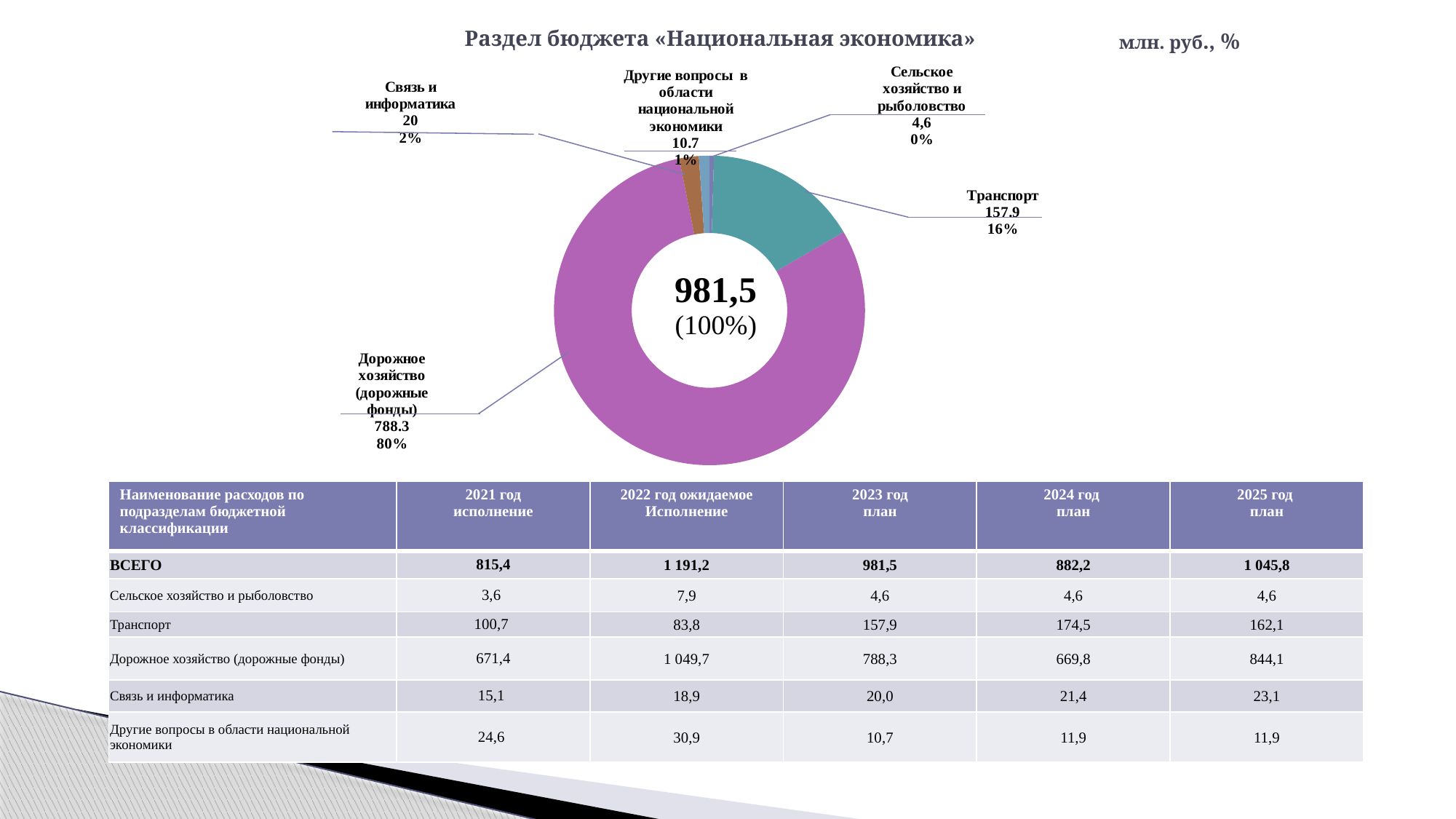
What is the difference between the values for Дорожное хозяйство (дорожные фонды) and Транспорт in the chart? 630.4 How many categories are shown in the chart? 5 What is the value shown for Связь и информатика in the chart? 20 What type of chart is shown on the slide? Pie (donut) chart Which category has the largest slice in the chart? Дорожное хозяйство (дорожные фонды) What percentage share does Транспорт have in the chart? 16% What percentage share does Дорожное хозяйство (дорожные фонды) have in the chart? 80% What is the value shown for Дорожное хозяйство (дорожные фонды) in the chart? 788.3 Which category has the smallest slice in the chart? Сельское хозяйство и рыболовство What is the value shown for Сельское хозяйство и рыболовство in the chart? 4,6 What is the value shown for Транспорт in the chart? 157.9 What total value is shown in the centre of the chart? 981,5